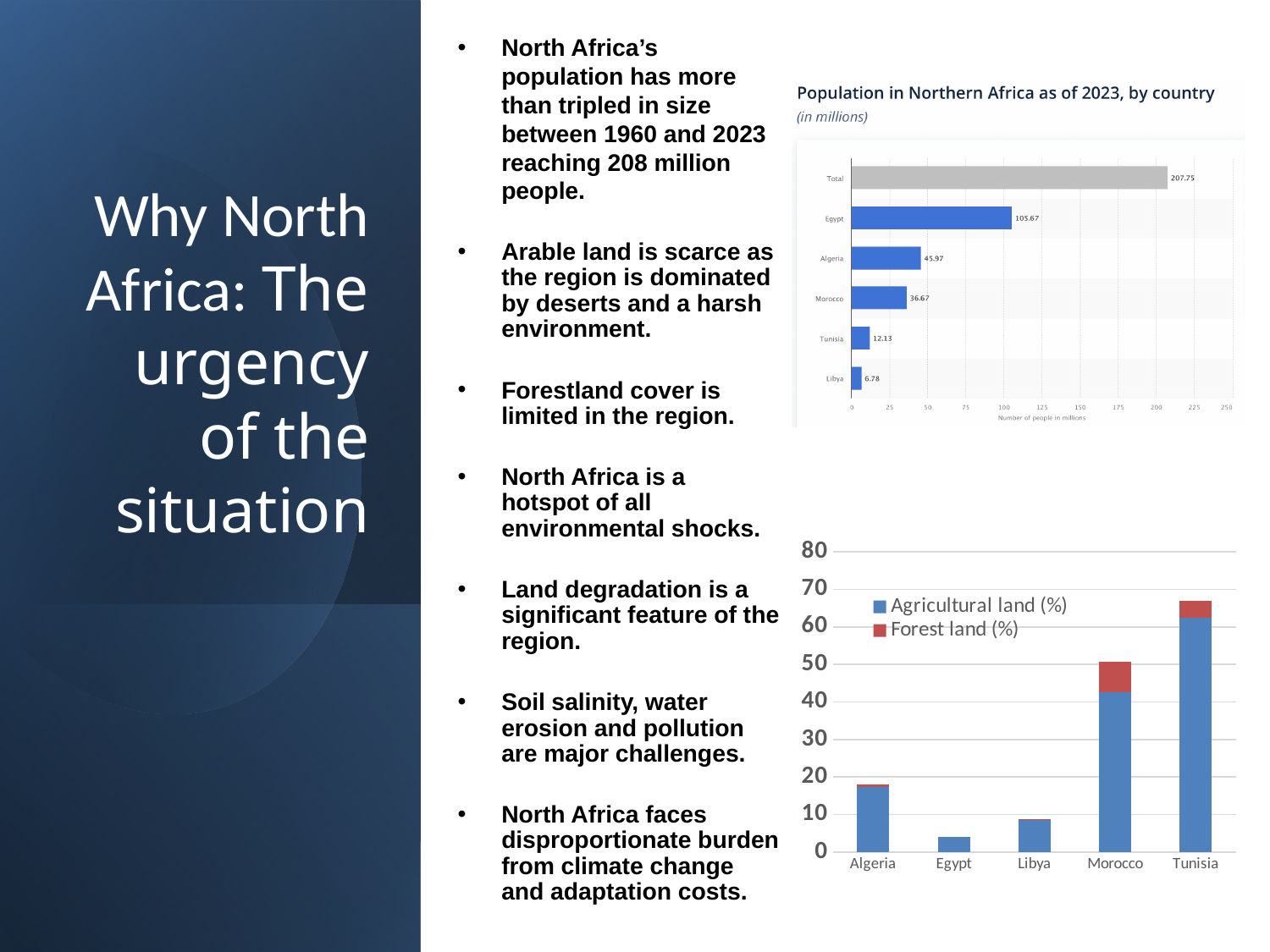
In the bottom chart, which country has the tallest stacked bar? Tunisia In the 'Population in Northern Africa as of 2023, by country' chart, what is the value for Egypt? 105.67 In the bottom chart, which country has the shortest stacked bar? Egypt In the 'Population in Northern Africa as of 2023, by country' chart, which is larger, the value for Morocco or the value for Tunisia? Morocco How many series does the legend of the bottom chart list? 2 In the bottom chart, is the Agricultural land (%) value for Morocco greater or less than 40? greater In the 'Population in Northern Africa as of 2023, by country' chart, what is the value for Tunisia? 12.13 In the 'Population in Northern Africa as of 2023, by country' chart, which individual country has the highest population? Egypt How many bars are shown in the 'Population in Northern Africa as of 2023, by country' chart? 6 In the 'Population in Northern Africa as of 2023, by country' chart, which individual country has the lowest population? Libya What type of chart is the 'Population in Northern Africa as of 2023, by country' chart? Bar chart In the 'Population in Northern Africa as of 2023, by country' chart, what is the difference between the values for Algeria and Morocco? 9.30